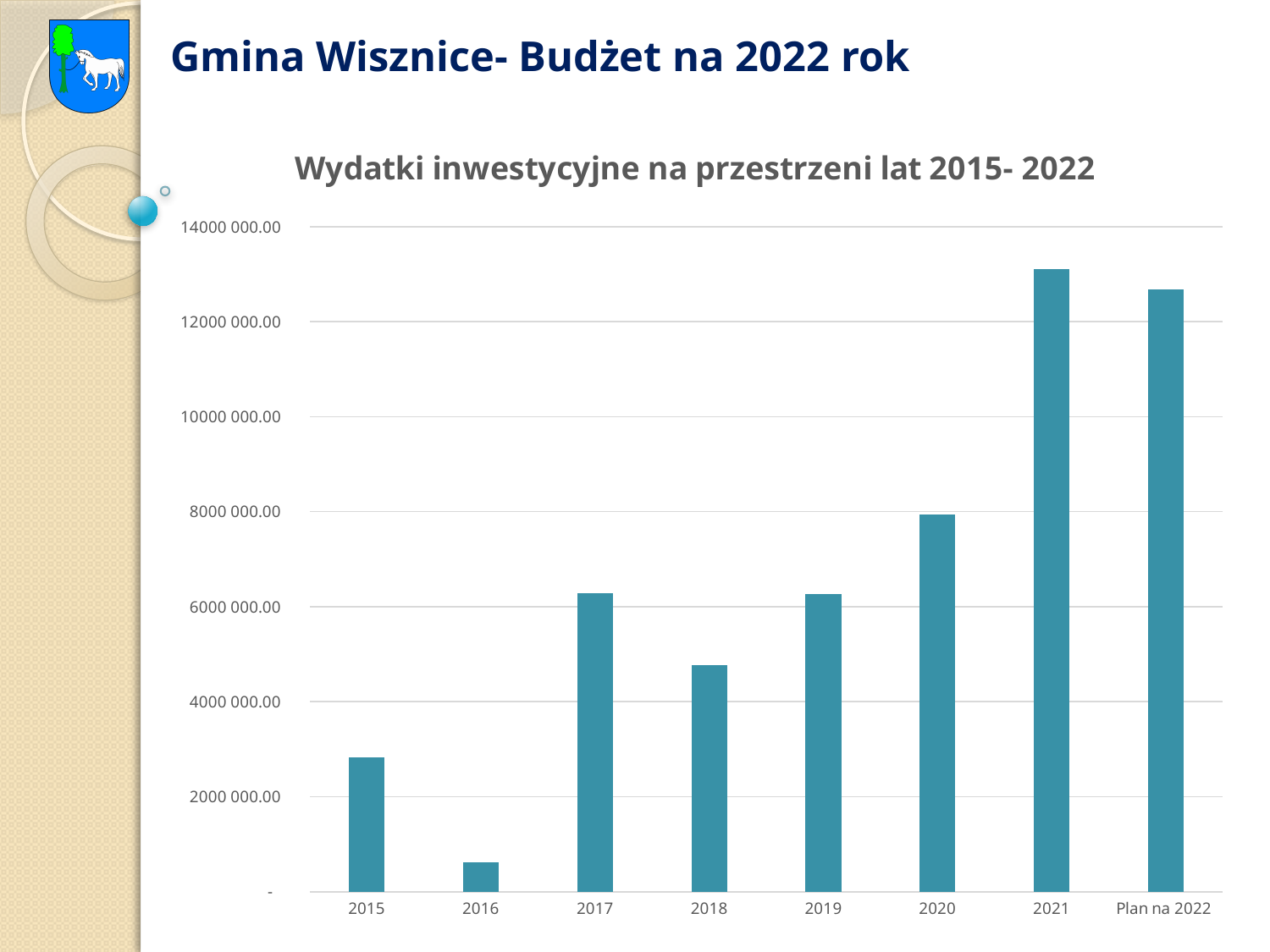
What kind of chart is shown on the slide? bar chart What is the title of the chart? Wydatki inwestycyjne na przestrzeni lat 2015- 2022 How many bars (categories) are shown in the chart? 8 Which is larger, the value for 2015 or the value for 2017? 2017 Is the value for 2018 greater or less than 4000 000.00? greater Which is larger, the value for 2020 or the value for 2018? 2020 Which category has the highest value? 2021 Is the value for 2016 greater or less than 2000 000.00? less Is the value for 2021 greater or less than 12000 000.00? greater Which category has the lowest value? 2016 Do the values rise or fall from 2016 to 2021? rise